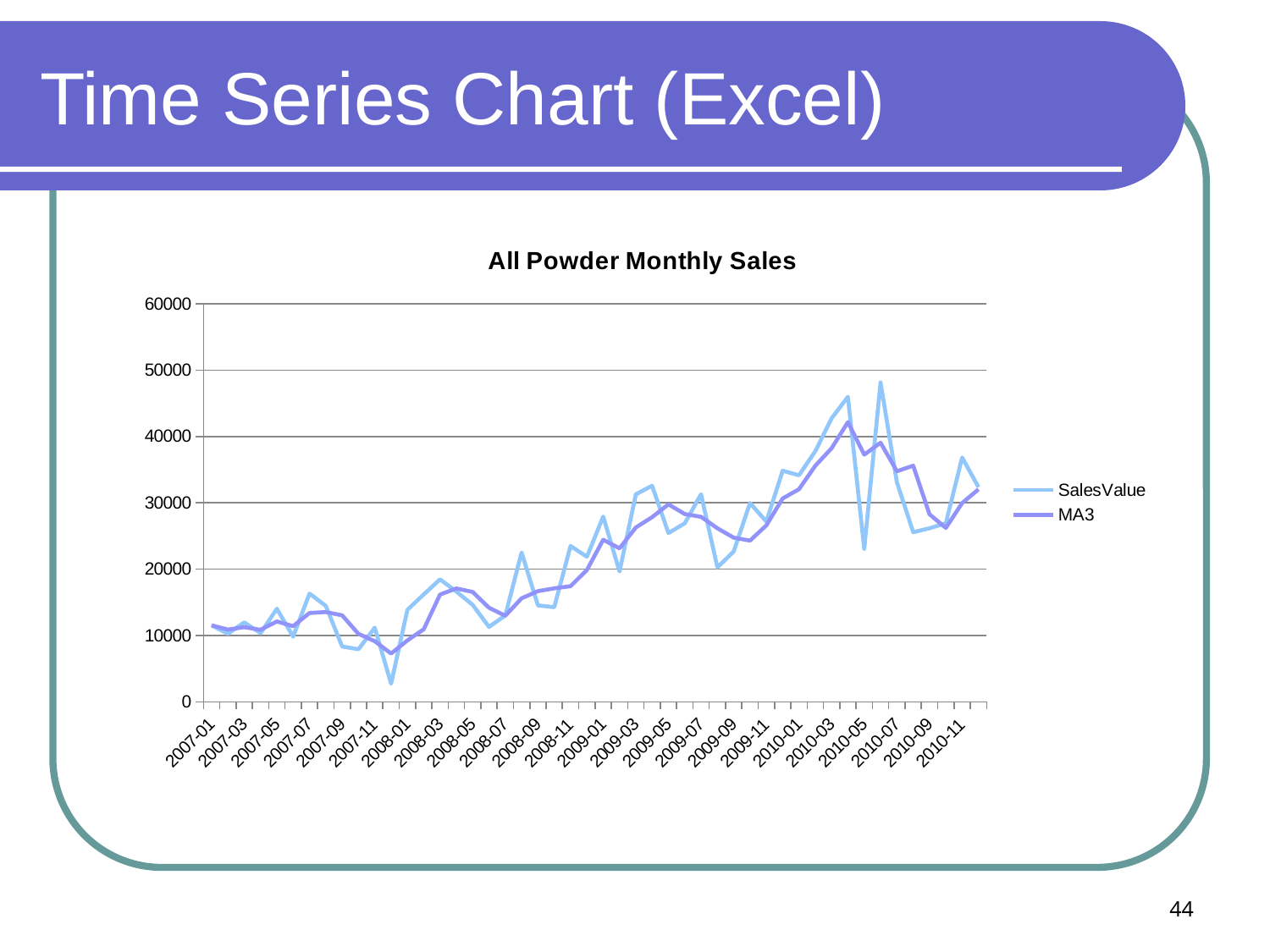
Which series reaches the highest peak on the chart? SalesValue Which two series are listed in the legend? SalesValue and MA3 Overall, do the SalesValue values rise or fall from 2007-01 to 2010-11? rise How many series does the legend list? 2 Is the MA3 value at 2007-01 greater or less than 20000? less Is the SalesValue value at 2008-01 greater or less than 10000? greater What is the highest value shown on the y axis? 60000 At 2010-05, which series has the larger value, SalesValue or MA3? MA3 Is the SalesValue value at 2010-07 greater or less than 40000? less What kind of chart is shown on the slide? line chart What is the title of the chart? All Powder Monthly Sales